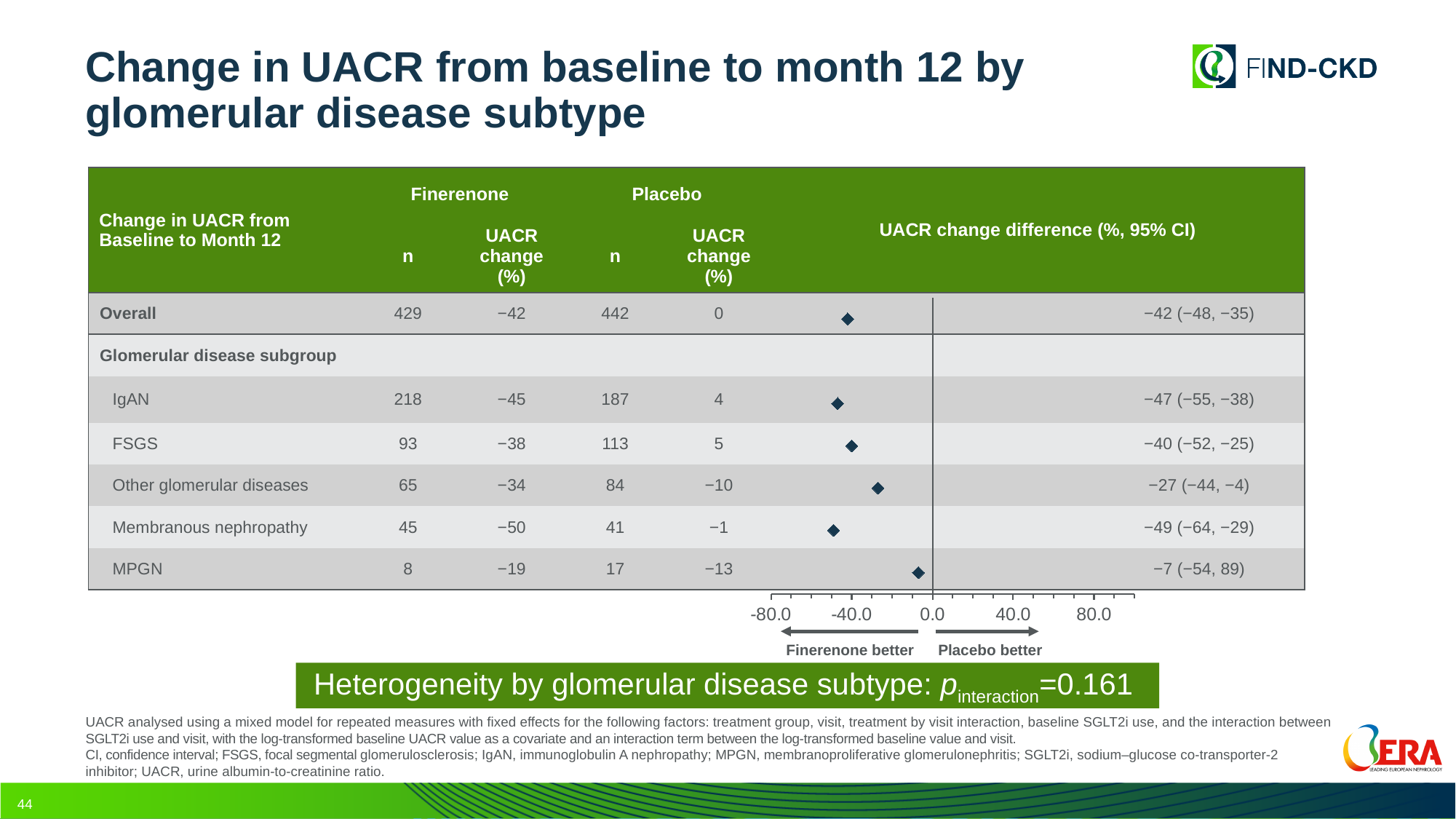
What is the difference between the UACR change difference for IgAN (−47) and FSGS (−40)? 7 Is the plotted point for MPGN greater or less than 0.0 on the x axis? less What is the 95% CI shown for the UACR change difference in the Membranous nephropathy subgroup? (−64, −29) Which has a more negative UACR change difference: FSGS or Other glomerular diseases? FSGS Which subgroup's point estimate lies closest to 0.0 on the forest plot? MPGN What label appears under the left arrow below the x axis of the forest plot? Finerenone better Which subgroup has the most negative (largest reduction) UACR change difference in the forest plot? Membranous nephropathy What is the UACR change difference (%) plotted for IgAN? −47 Is the plotted point for Other glomerular diseases greater or less than −40.0? greater What kind of chart is used to display the UACR change differences? Forest plot How many point estimates (diamonds) are plotted in the forest plot? 6 What is the UACR change difference (%) plotted for the Overall row? −42